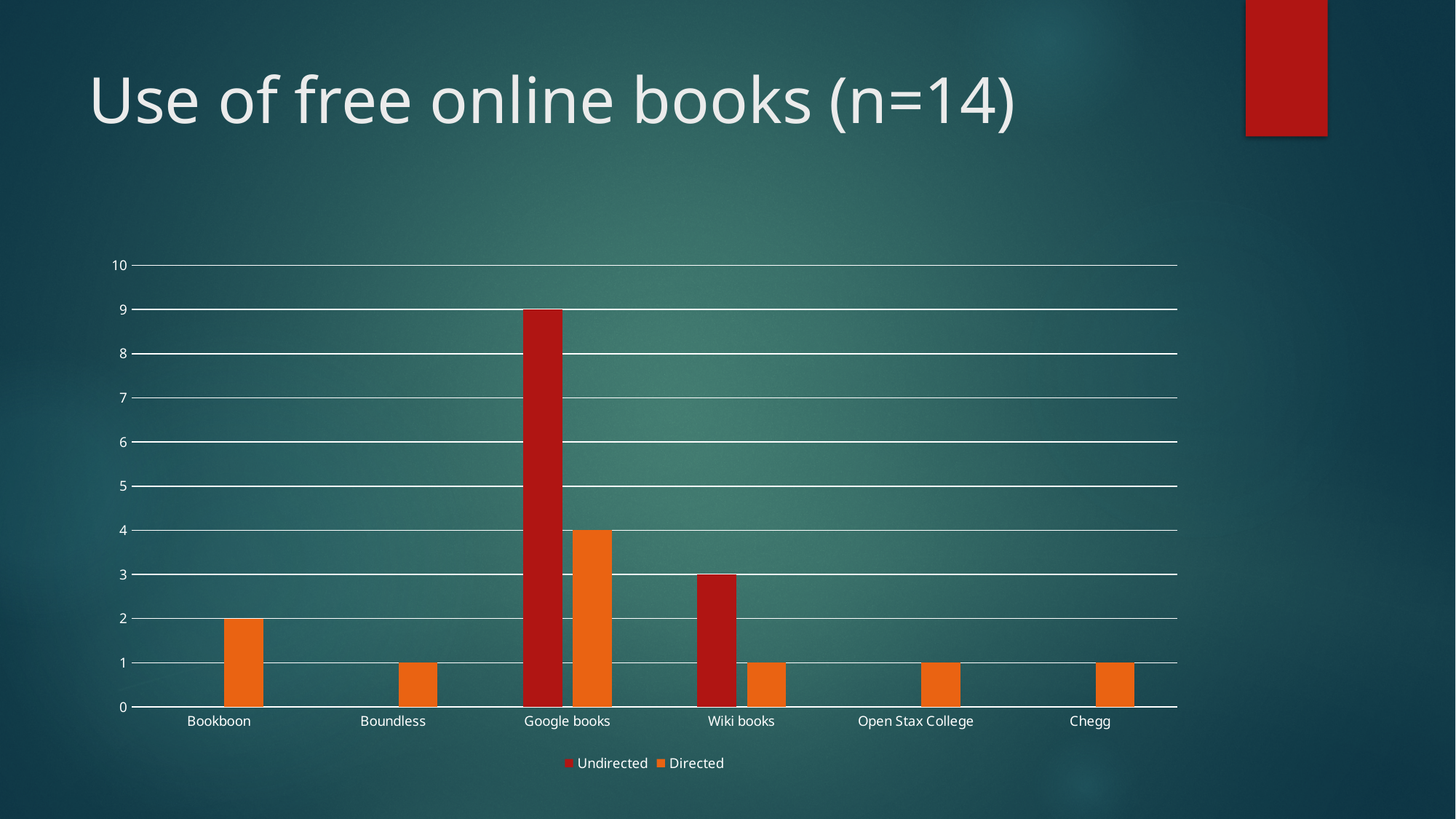
Which category has the highest Undirected value? Google books What is the difference between the Undirected and Directed values for Google books? 5 What type of chart is shown on the slide? bar chart How many series does the legend list? 2 What is the title of the chart? Use of free online books (n=14) What is the Undirected value for Wiki books? 3 How many categories are shown on the x axis? 6 What is the Undirected value for Google books? 9 What is the Directed value for Google books? 4 What is the Directed value for Bookboon? 2 Is the Undirected value for Google books greater or less than 5? greater Which is larger, the Directed value for Bookboon or the Directed value for Chegg? Bookboon